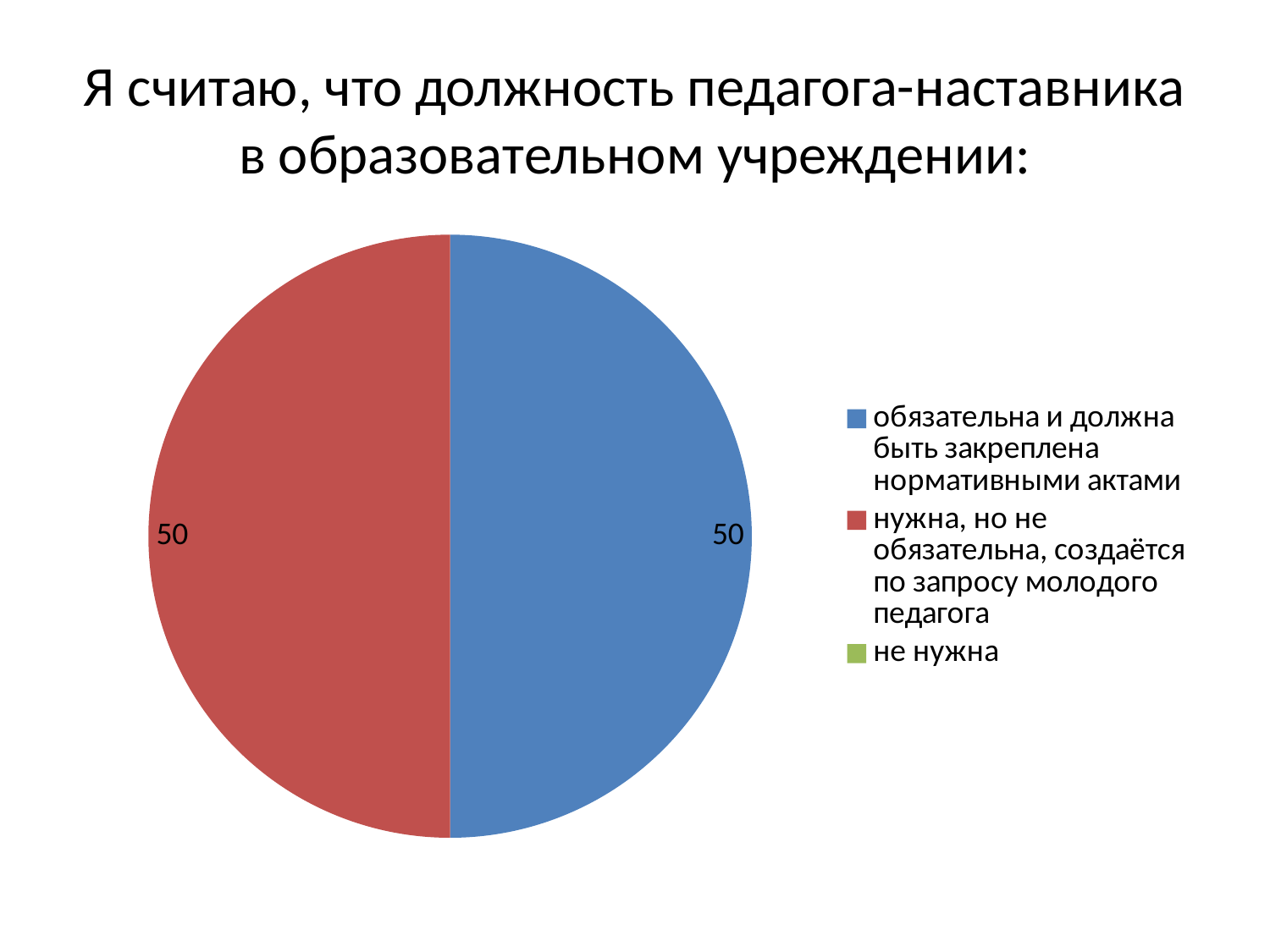
How many slices are visible in the pie chart? 2 What share of the pie does the slice "обязательна и должна быть закреплена нормативными актами" represent? 50% What colour is the slice for "нужна, но не обязательна, создаётся по запросу молодого педагога"? Red What colour is used for the legend entry "не нужна"? Green What value is shown for the slice "нужна, но не обязательна, создаётся по запросу молодого педагога"? 50 How many entries does the legend list? 3 Which is larger, the value for "обязательна и должна быть закреплена нормативными актами" or the value for "нужна, но не обязательна, создаётся по запросу молодого педагога", or are they equal? They are equal What kind of chart is shown on the slide? Pie chart What is the total of the two labelled slice values? 100 What value is shown for the slice "обязательна и должна быть закреплена нормативными актами"? 50 What is the difference between the two labelled slice values? 0